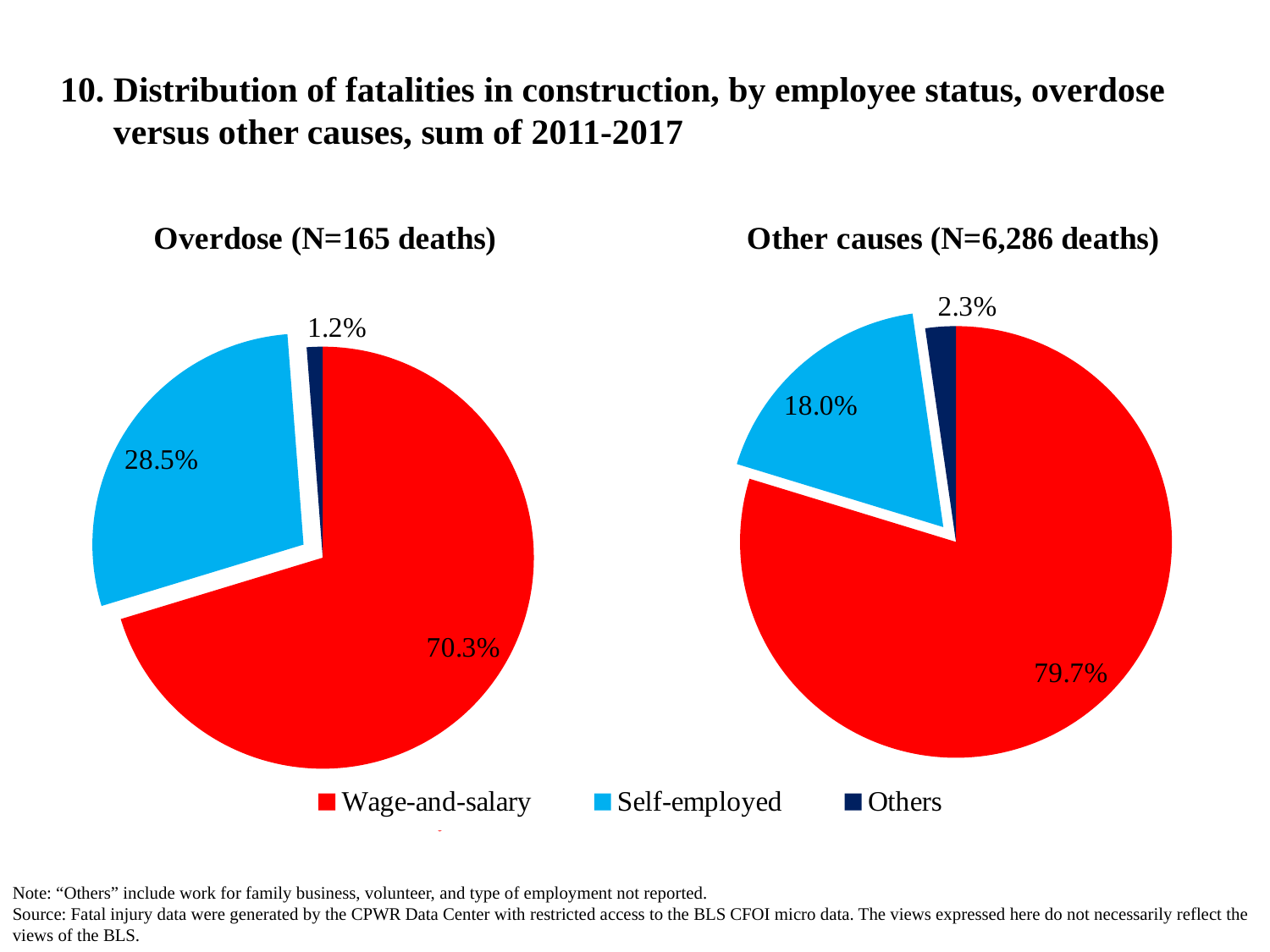
Which is larger: the Wage-and-salary share in the Overdose chart or in the Other causes chart? Other causes What colour represents Self-employed in the legend? Light blue How many categories does each pie chart show? 3 In the Overdose pie chart, which employee status has the largest share? Wage-and-salary What type of chart is used on this slide? Pie chart In the Overdose pie chart, what share of fatalities is Self-employed? 28.5% In the Other causes pie chart, what share of fatalities is Self-employed? 18.0% What is the difference between the Self-employed share in the Overdose chart and the Self-employed share in the Other causes chart? 10.5% In the Overdose pie chart, what share of fatalities is Wage-and-salary? 70.3% How many deaths does the Overdose chart title say it covers? 165 In the Other causes pie chart, which employee status has the smallest share? Others In the Other causes pie chart, what share of fatalities is Others? 2.3%